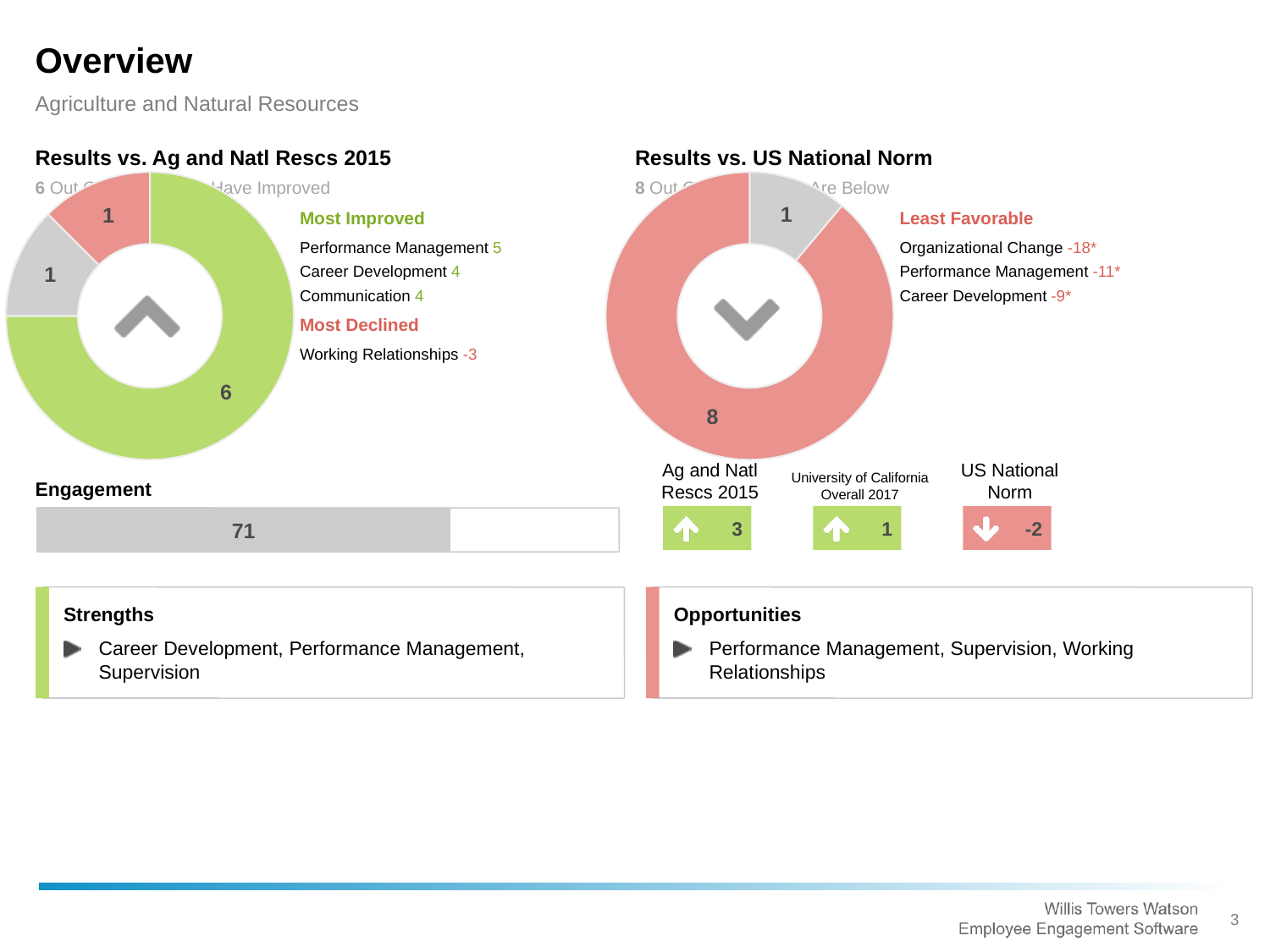
In the 'Results vs. US National Norm' chart, what value is shown on the grey slice? 1 In the 'Results vs. US National Norm' chart, what is the difference between the red slice and the grey slice? 7 In the 'Results vs. Ag and Natl Rescs 2015' chart, which slice is the largest? the green slice (6) In the 'Results vs. Ag and Natl Rescs 2015' chart, what value is shown on the red slice? 1 In the 'Results vs. US National Norm' chart, which slice is the largest? the red slice (8) How many slices does the 'Results vs. Ag and Natl Rescs 2015' chart have? 3 What value is shown on the Engagement bar? 71 In the 'Results vs. Ag and Natl Rescs 2015' chart, what value is shown on the green slice? 6 How many slices does the 'Results vs. US National Norm' chart have? 2 In the 'Results vs. Ag and Natl Rescs 2015' chart, what is the difference between the green slice and the red slice? 5 In the 'Results vs. US National Norm' chart, what value is shown on the red slice? 8 What kind of chart is 'Results vs. Ag and Natl Rescs 2015'? pie chart (donut)